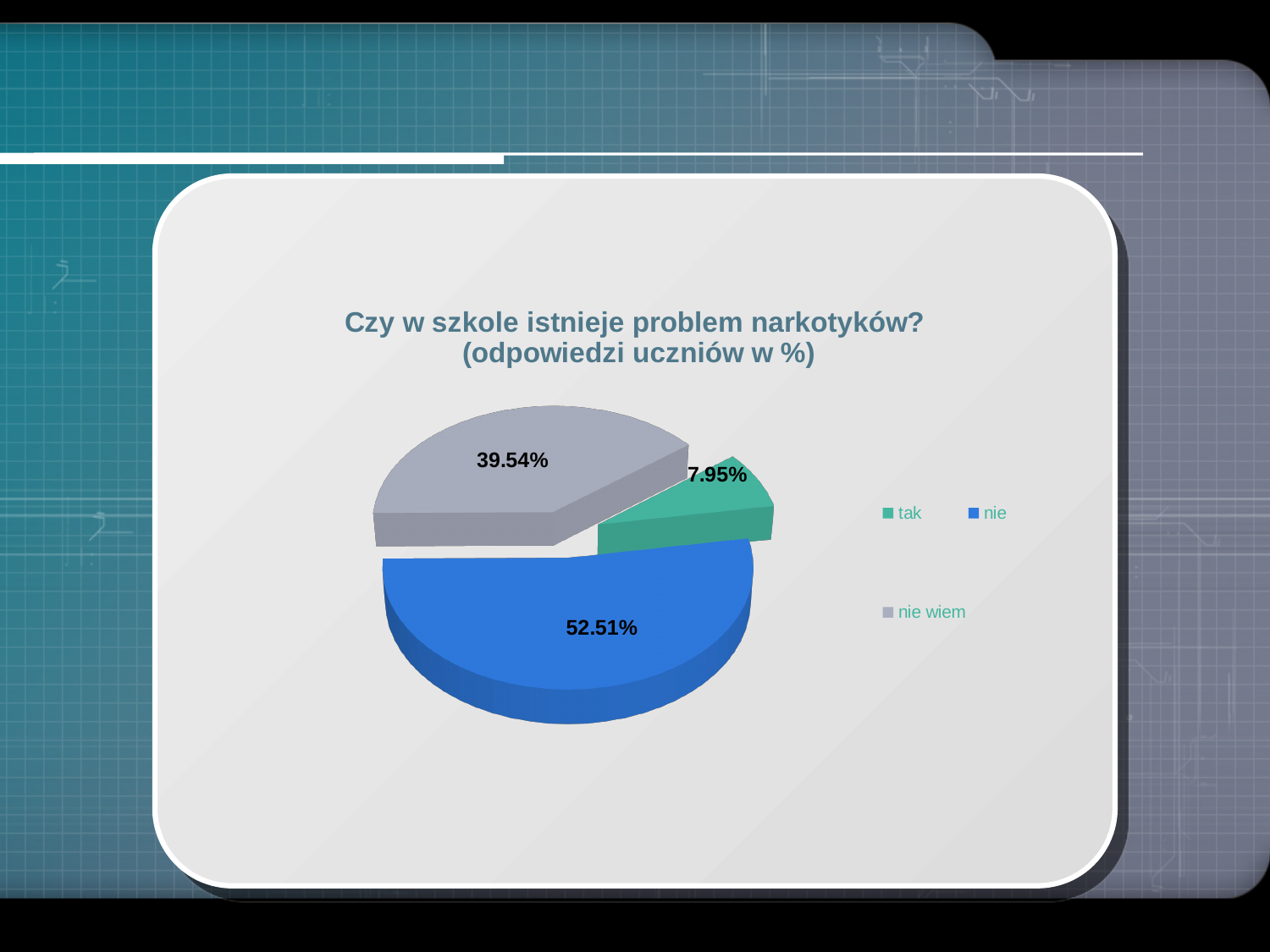
What percentage of students answered "nie"? 52.51% What is the title of the chart? Czy w szkole istnieje problem narkotyków? (odpowiedzi uczniów w %) What type of chart is shown on the slide? pie chart What colour is the slice for "nie"? blue How many entries does the legend list? 3 Which answer has the largest share of the pie? nie What percentage of students answered "tak"? 7.95% How many slices does the pie chart have? 3 Which is larger, the share for "nie wiem" or the share for "tak"? nie wiem What percentage of students answered "nie wiem"? 39.54% Which answer has the smallest share of the pie? tak What is the difference in percentage points between the "nie" and "nie wiem" slices? 12.97